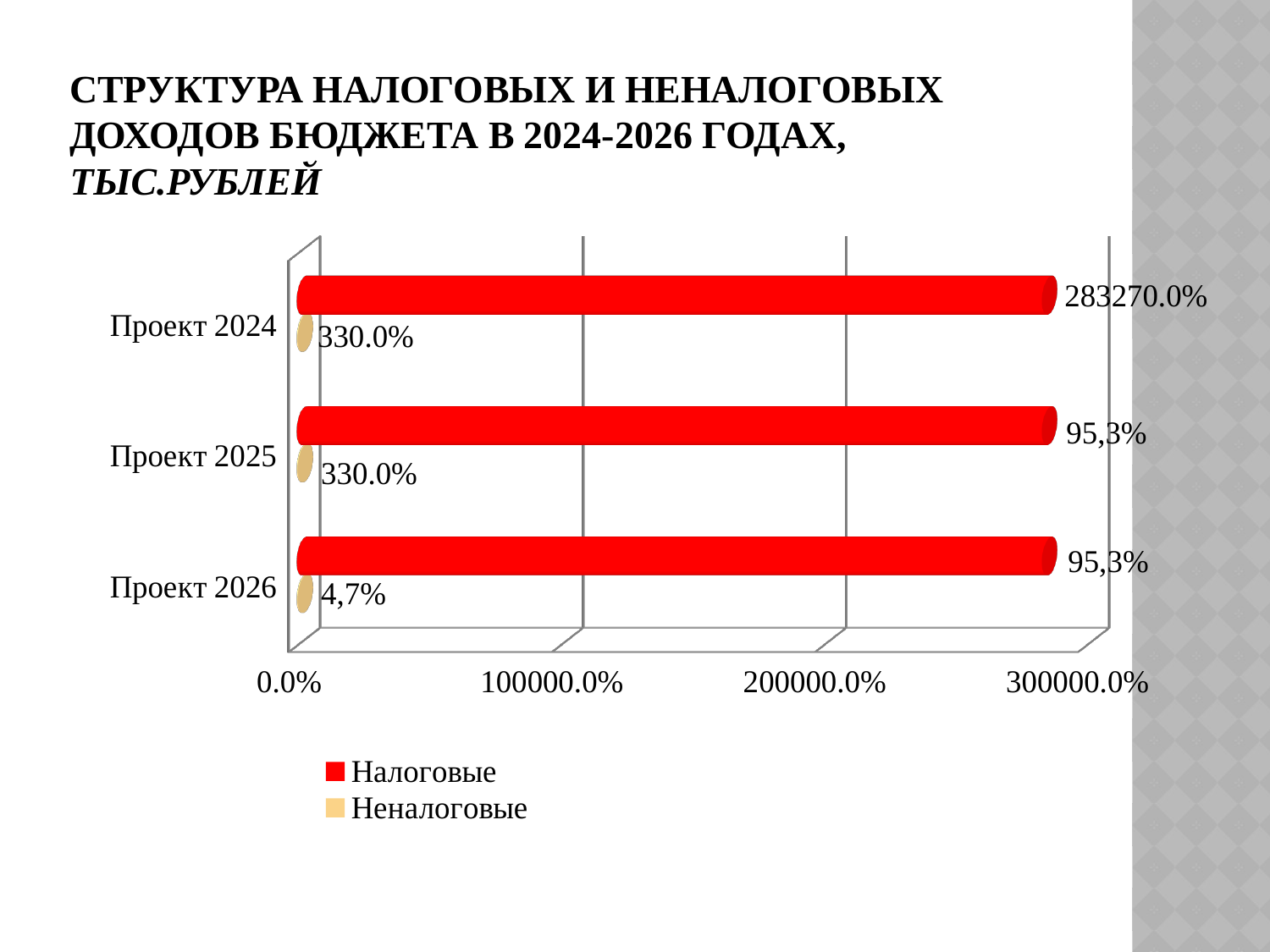
What is the data label for Налоговые in Проект 2024? 283270.0% What is the data label for Неналоговые in Проект 2024? 330.0% In Проект 2024, which bar is longer: Налоговые or Неналоговые? Налоговые Which colour represents the Неналоговые series in the legend? beige What is the data label for Налоговые in Проект 2026? 95,3% What type of chart is shown on the slide? bar chart What is the data label for Неналоговые in Проект 2026? 4,7% How many categories are shown on the chart? 3 How many series does the legend list? 2 What is the data label for Налоговые in Проект 2025? 95,3% Is the Налоговые bar for Проект 2026 greater or less than 200000.0% on the axis? greater What is the data label for Неналоговые in Проект 2025? 330.0%